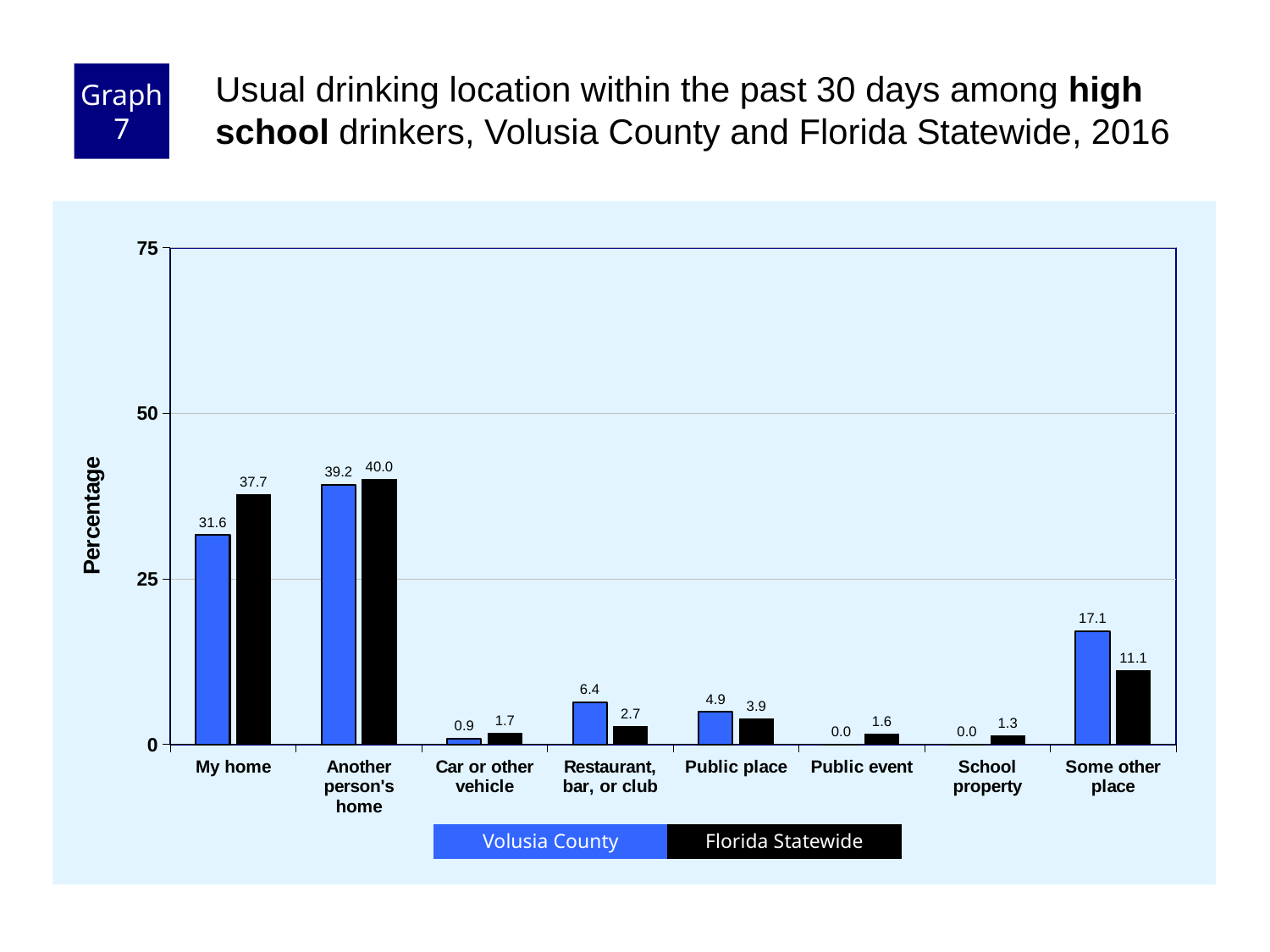
What is the difference between the Florida Statewide and Volusia County values for "My home"? 6.1 Which is larger for "Some other place": Volusia County or Florida Statewide? Volusia County How many series does the legend list? 2 Which category has the lowest Florida Statewide value? School property What is the label on the y axis? Percentage What kind of chart is shown on the slide? Bar chart Which category has the highest Florida Statewide value? Another person's home How many categories are shown on the x axis? 8 What is the Florida Statewide value for "Some other place"? 11.1 What is the Volusia County value for "My home"? 31.6 Is the Volusia County value for "Another person's home" greater or less than 25? greater What is the Volusia County value for "Restaurant, bar, or club"? 6.4